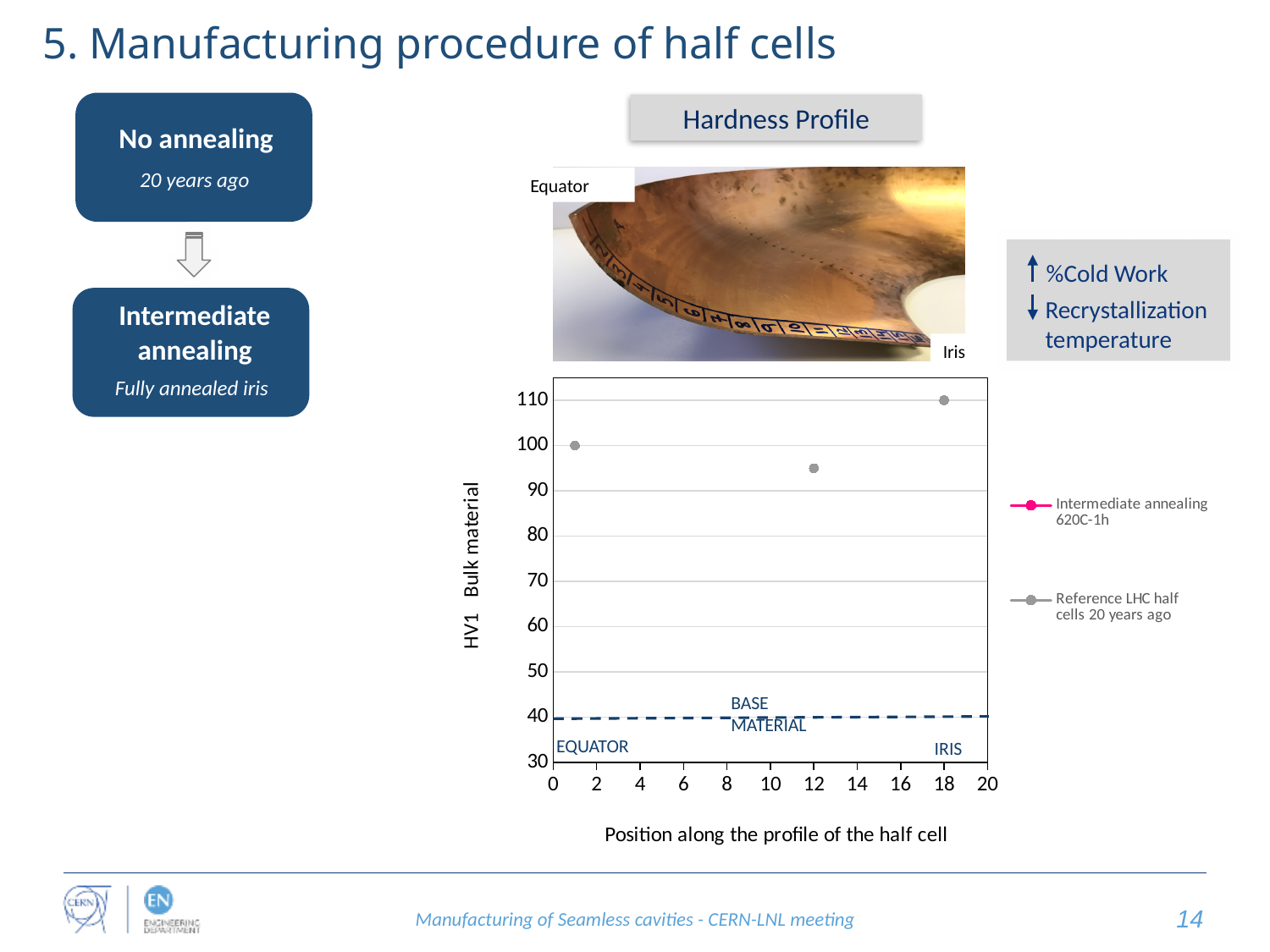
At which position along the profile does the 'Reference LHC half cells 20 years ago' series reach its highest hardness? 18 Is the hardness value of the reference series at position 18 greater or less than 100? greater Is the hardness value of the reference series at position 12 greater or less than 100? less What is the title of the vertical axis of the Hardness Profile chart? HV1 Bulk material Which has the higher hardness in the reference series: the point near position 1 or the point at position 12? the point near position 1 Does the hardness of the reference series rise or fall between position 12 and position 18? rise What kind of chart is the Hardness Profile chart? scatter chart How many series does the legend of the Hardness Profile chart list? 2 How many data points are plotted for the 'Reference LHC half cells 20 years ago' series? 3 At which position along the profile does the 'Reference LHC half cells 20 years ago' series have its lowest hardness? 12 Is the hardness value of the reference series at position 12 greater or less than 90? greater What label is given to the dashed horizontal line at 40 on the Hardness Profile chart? BASE MATERIAL